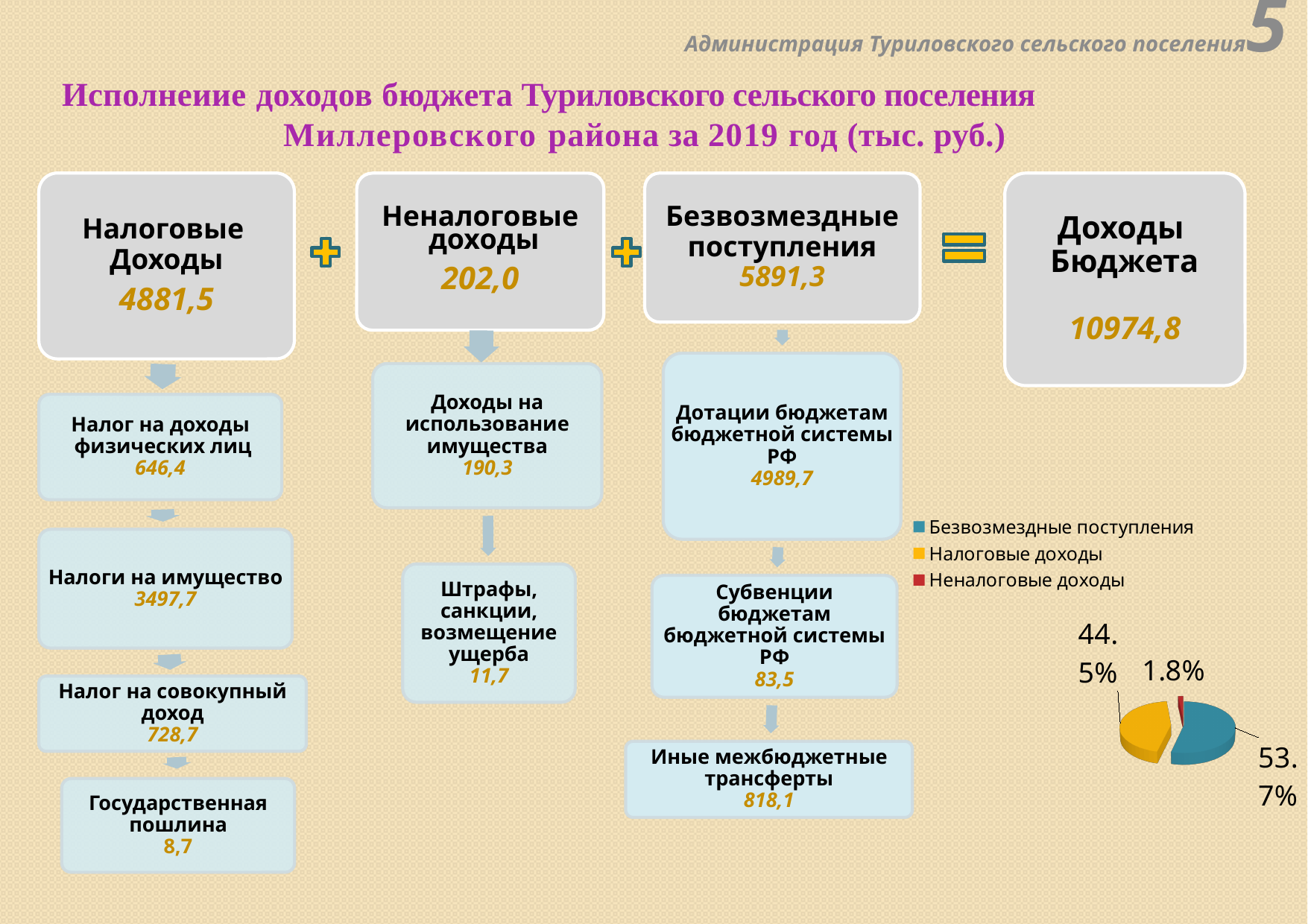
In the pie chart, which is larger: Безвозмездные поступления or Налоговые доходы? Безвозмездные поступления What share of the pie chart is Неналоговые доходы? 1.8% How many slices does the pie chart have? 3 Which category has the smallest slice in the pie chart? Неналоговые доходы What is the difference in percentage points between the Безвозмездные поступления slice and the Налоговые доходы slice? 9.2 What kind of chart is shown on the slide? pie chart What colour is the Безвозмездные поступления slice in the pie chart? teal What colour is the Налоговые доходы slice in the pie chart? yellow Which category has the largest slice in the pie chart? Безвозмездные поступления What share of the pie chart is Безвозмездные поступления? 53.7% How many entries does the pie chart's legend list? 3 What share of the pie chart is Налоговые доходы? 44.5%